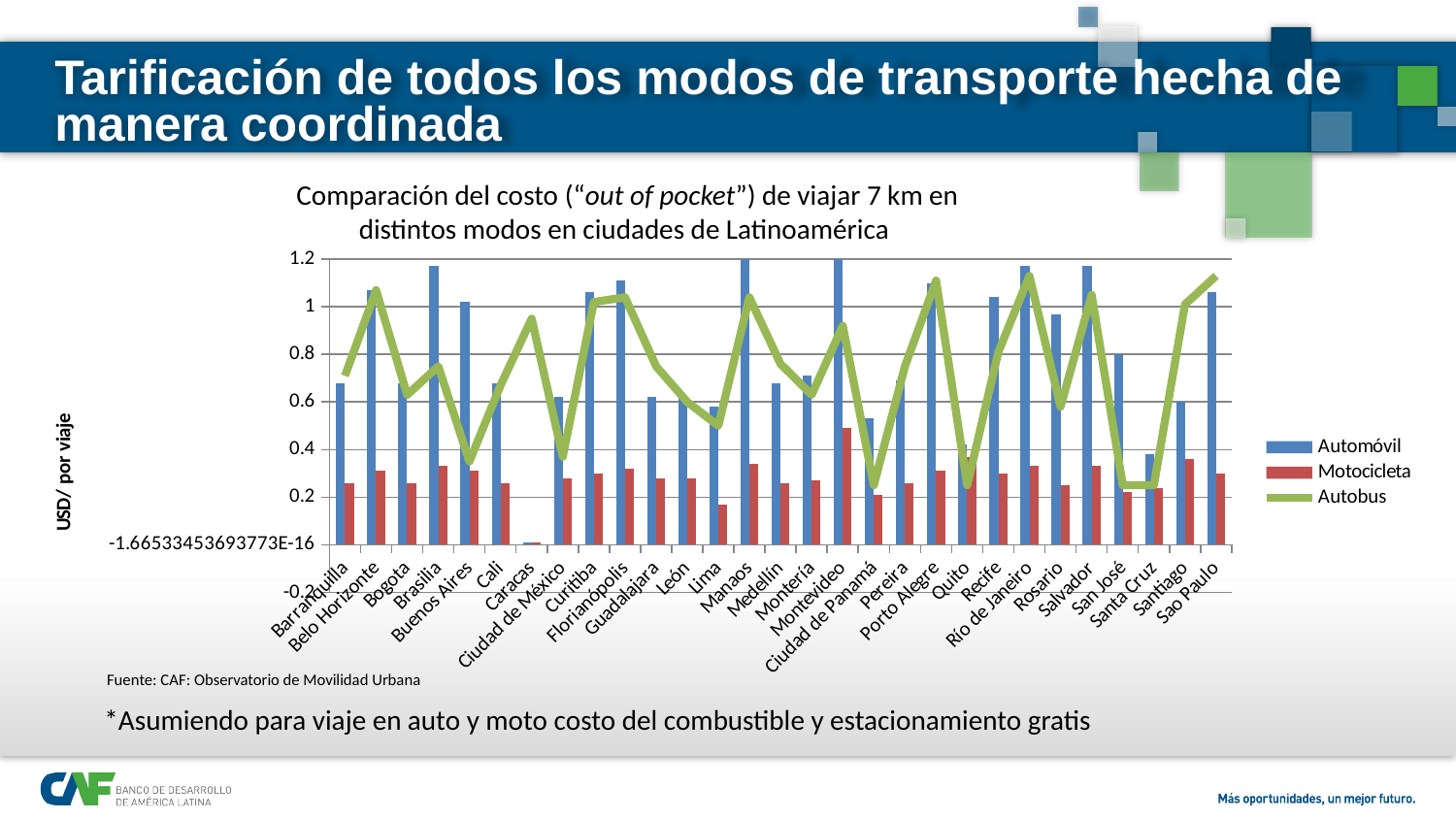
Which city has the lowest Automóvil value? Caracas How many cities are shown on the x axis of the chart? 29 Which series are listed in the chart legend? Automóvil, Motocicleta, Autobus Is the Automóvil value for Manaos greater or less than 1? greater What is the title of the chart? Comparación del costo ("out of pocket") de viajar 7 km en distintos modos en ciudades de Latinoamérica Is the Motocicleta value for Montevideo greater or less than 0.4? greater Is the Autobus value for Ciudad de Panamá greater or less than 0.4? less For Bogota, which is larger, the Automóvil value or the Motocicleta value? Automóvil Which city has the highest Motocicleta value? Montevideo How many series does the chart legend list? 3